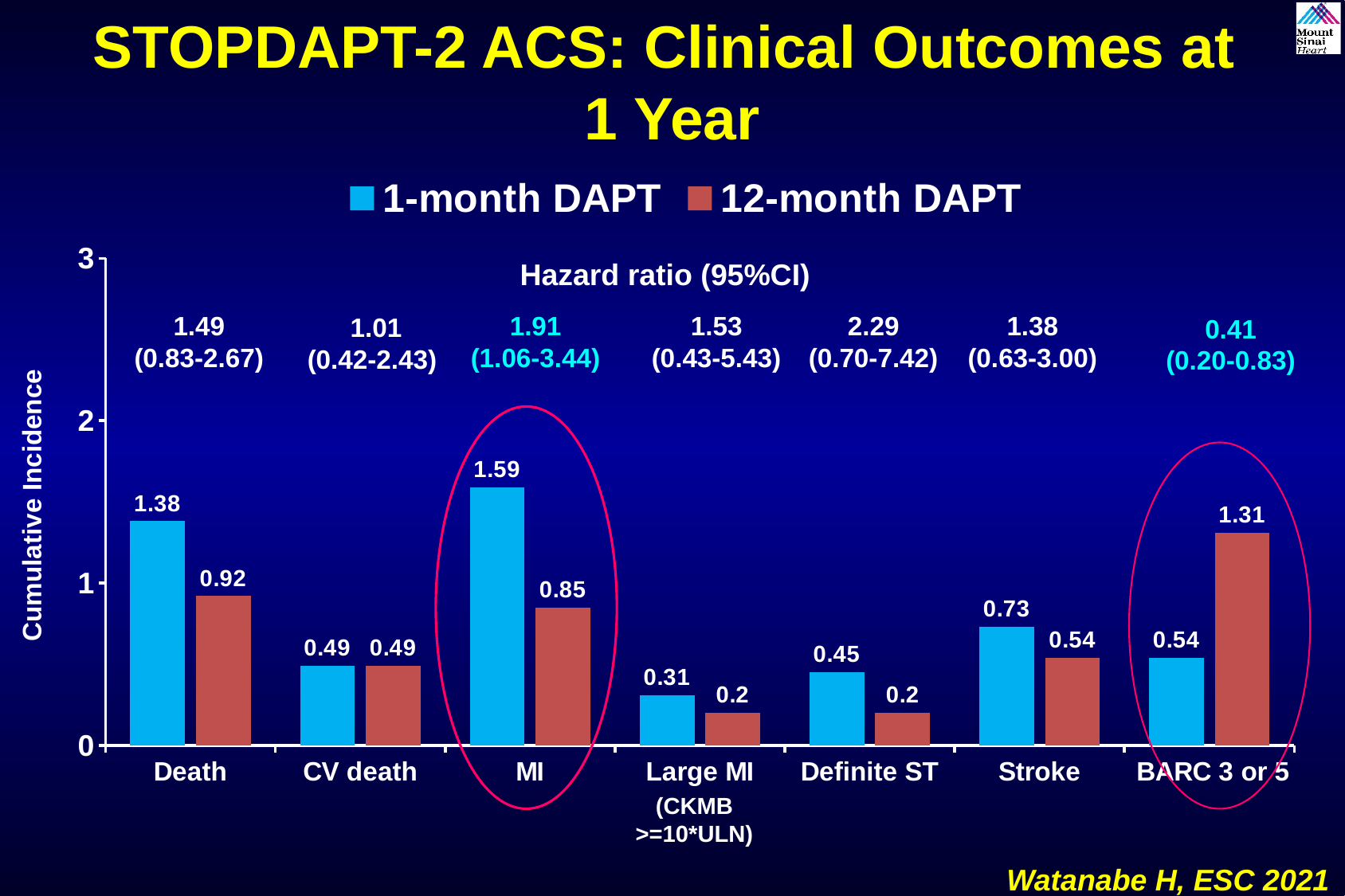
Which category has the lowest cumulative incidence for the 1-month DAPT group? Large MI Which category has the highest cumulative incidence for the 1-month DAPT group? MI What is the hazard ratio (95% CI) shown for BARC 3 or 5? 0.41 (0.20-0.83) For BARC 3 or 5, which group has the higher cumulative incidence, 1-month DAPT or 12-month DAPT? 12-month DAPT What is the difference between the 1-month DAPT and 12-month DAPT cumulative incidence for MI? 0.74 Is the 1-month DAPT value for Death greater or less than 1? greater What is the cumulative incidence of BARC 3 or 5 bleeding for the 12-month DAPT group? 1.31 What is the cumulative incidence of Death for the 12-month DAPT group? 0.92 What kind of chart is shown on the slide? Bar chart How many outcome categories are shown on the x axis? 7 How many series does the legend list? 2 What is the cumulative incidence of MI for the 1-month DAPT group? 1.59